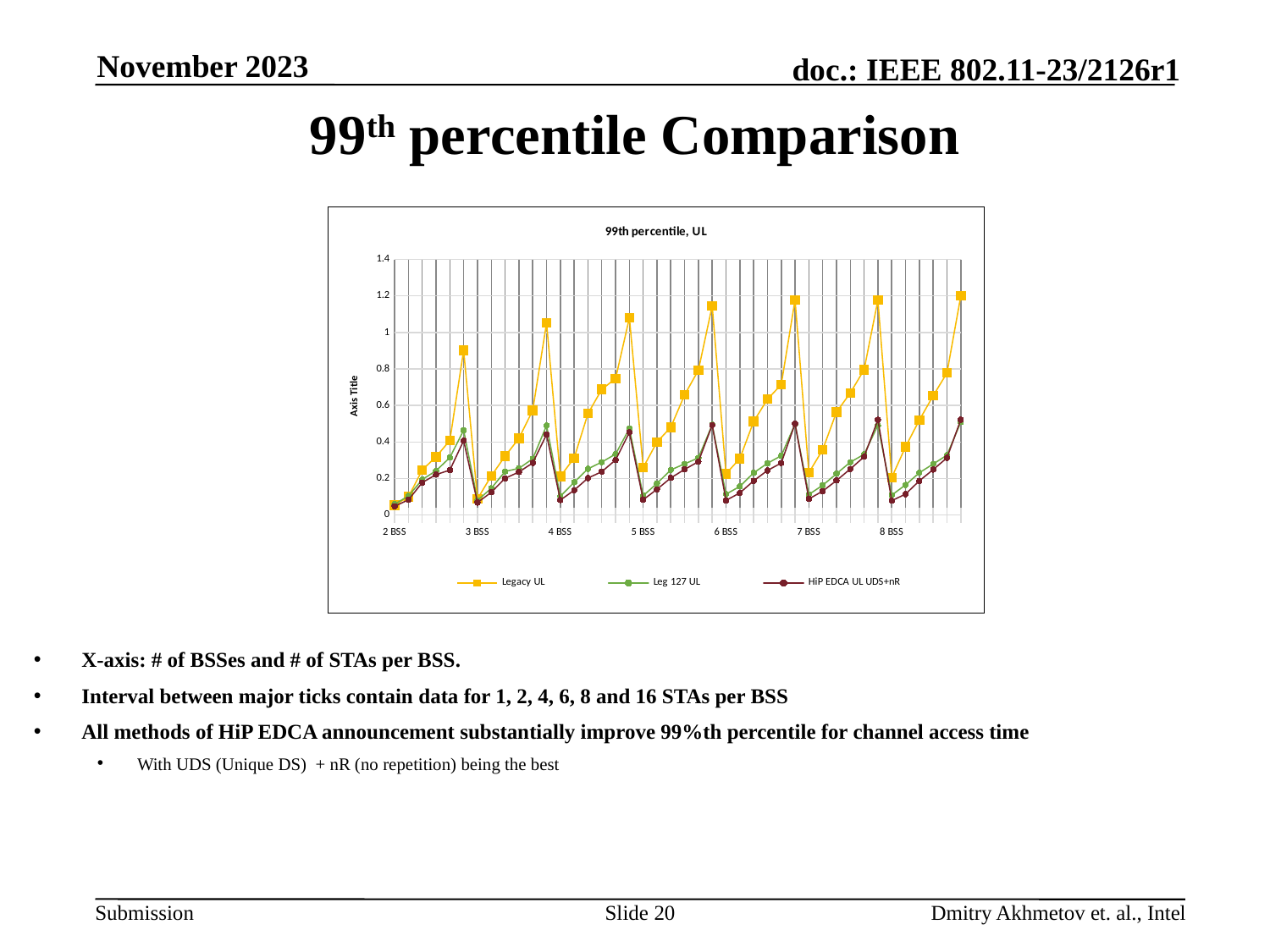
How many series does the legend list? 3 What is the title of the chart? 99th percentile, UL Is the highest HiP EDCA UL UDS+nR value in the 8 BSS interval greater or less than 0.8? less Is the highest Legacy UL value in the 3 BSS interval greater or less than 0.8? greater Is the highest Legacy UL value in the 2 BSS interval greater or less than 1.2? less How many BSS category labels are shown on the x axis? 7 What kind of chart is shown on the slide? line chart Which series is drawn in yellow with square markers? Legacy UL At the last point of the 8 BSS interval, which is larger: Legacy UL or HiP EDCA UL UDS+nR? Legacy UL Which series reaches the highest value on the chart? Legacy UL